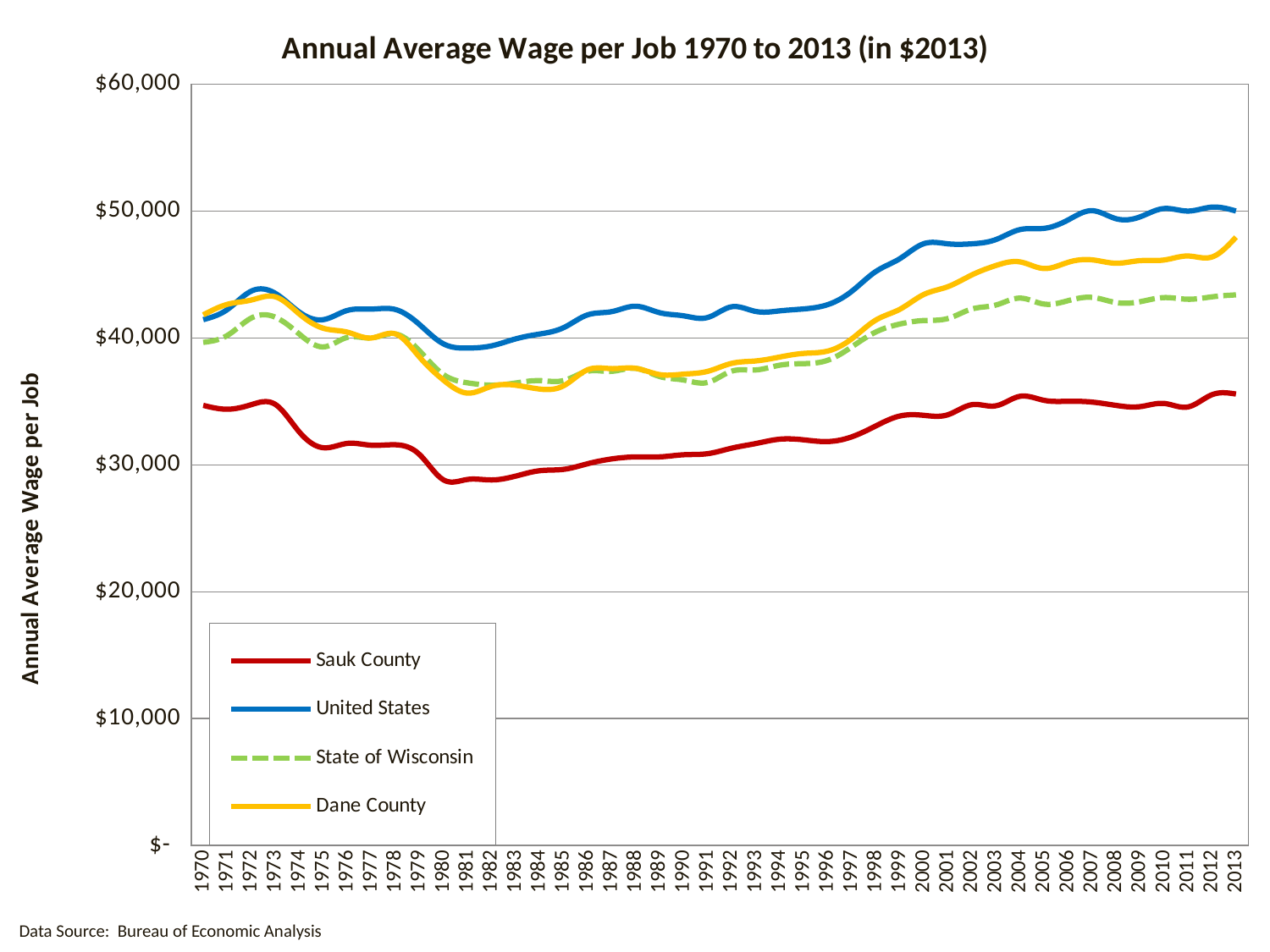
What is the title of the chart? Annual Average Wage per Job 1970 to 2013 (in $2013) How many years are plotted along the x axis? 44 How many series does the legend list? 4 Which series has the lowest values across the whole period? Sauk County What kind of chart is shown on the slide? line chart Is the value for Dane County in 2013 greater or less than $40,000? greater Is the value for United States in 2013 greater or less than $40,000? greater Which series has the highest value in 2013? United States Is the value for Sauk County in 1980 greater or less than $30,000? less Does the United States line rise or fall from 1990 to 2013? rise In 2013, which is larger: Dane County or State of Wisconsin? Dane County